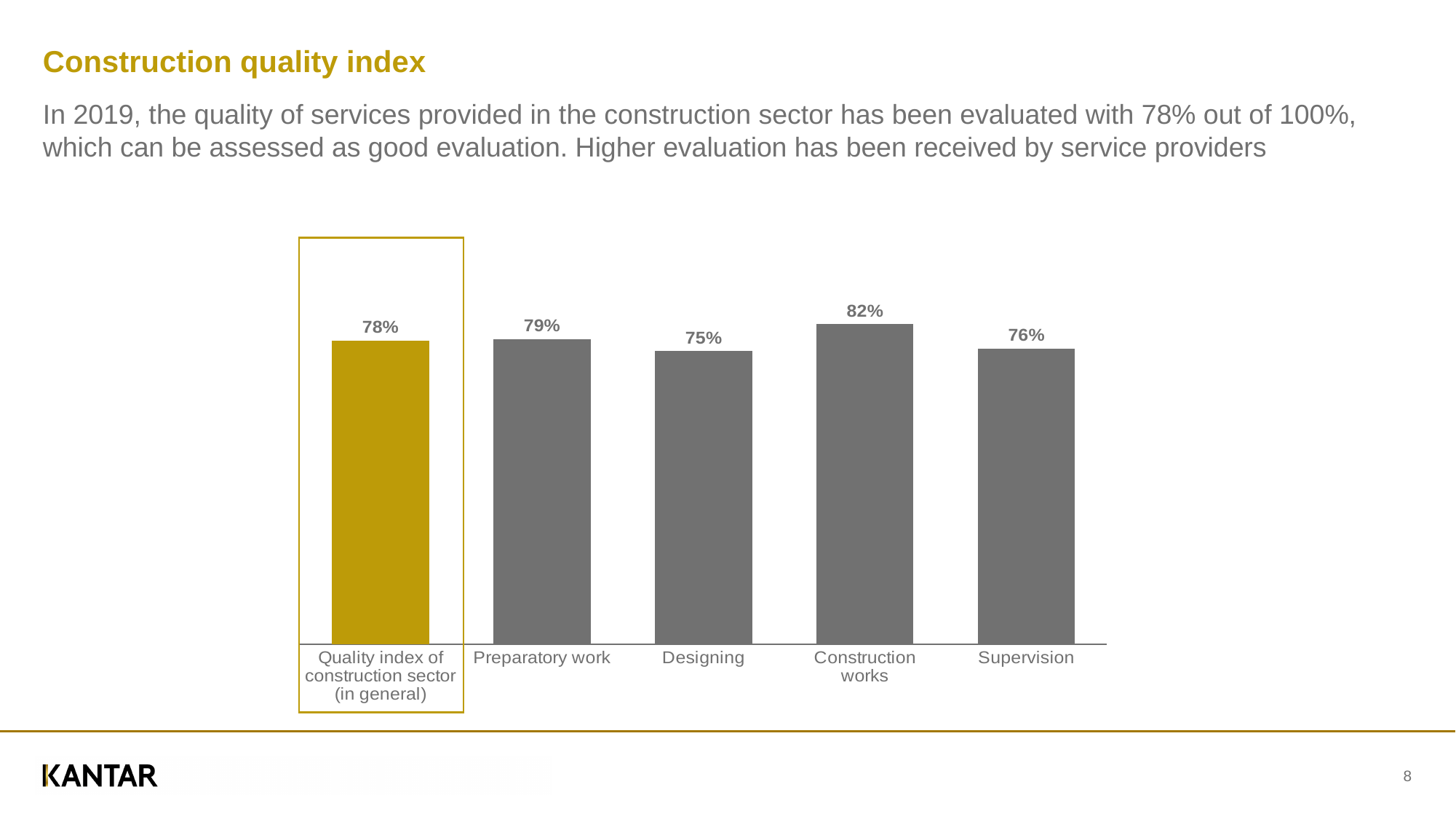
What kind of chart is shown on the slide? Bar chart Which is larger, the value for Preparatory work or the value for Supervision? Preparatory work What is the difference between the values for Preparatory work and Supervision? 3% Which category has the lowest value? Designing Which bar is highlighted in a gold colour? Quality index of construction sector (in general) What is the value for Designing? 75% What is the value for Construction works? 82% Which category has the highest value? Construction works What is the value for Supervision? 76% What is the value for Quality index of construction sector (in general)? 78% What is the difference between the values for Construction works and Designing? 7% How many categories are shown in the chart? 5